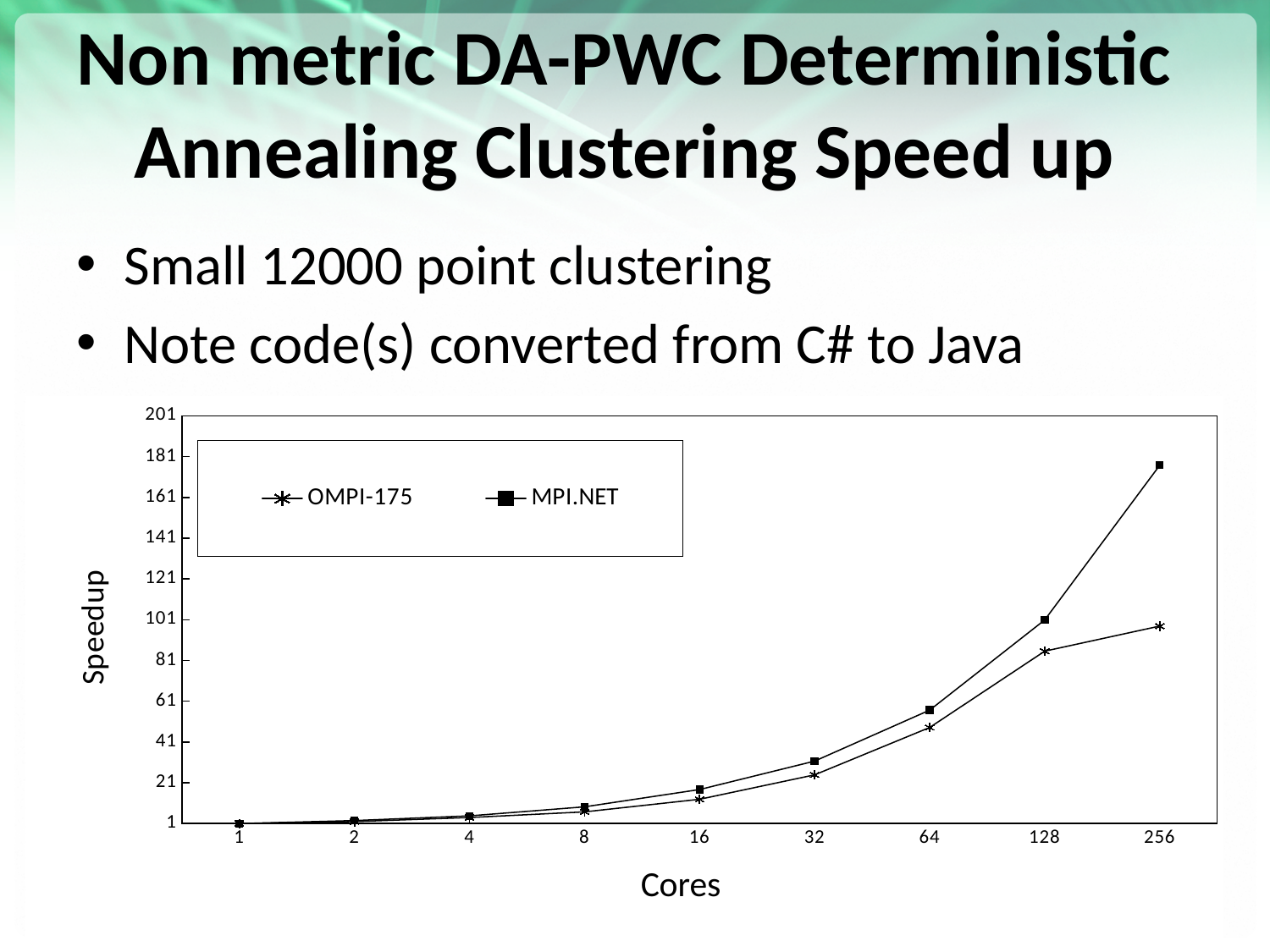
How many series does the legend list? 2 At 128 cores, which series has the higher speedup, OMPI-175 or MPI.NET? MPI.NET At 256 cores, which series has the higher speedup, OMPI-175 or MPI.NET? MPI.NET Is the speedup for MPI.NET at 64 cores greater or less than 41? greater Is the speedup for MPI.NET at 256 cores greater or less than 161? greater What kind of chart is shown on the slide? line chart Is the speedup for OMPI-175 at 256 cores greater or less than 81? greater Which series reaches the highest speedup on the chart? MPI.NET What is the label of the x axis? Cores Does the speedup for MPI.NET rise or fall as the number of cores increases? rise How many core counts are plotted along the x axis? 9